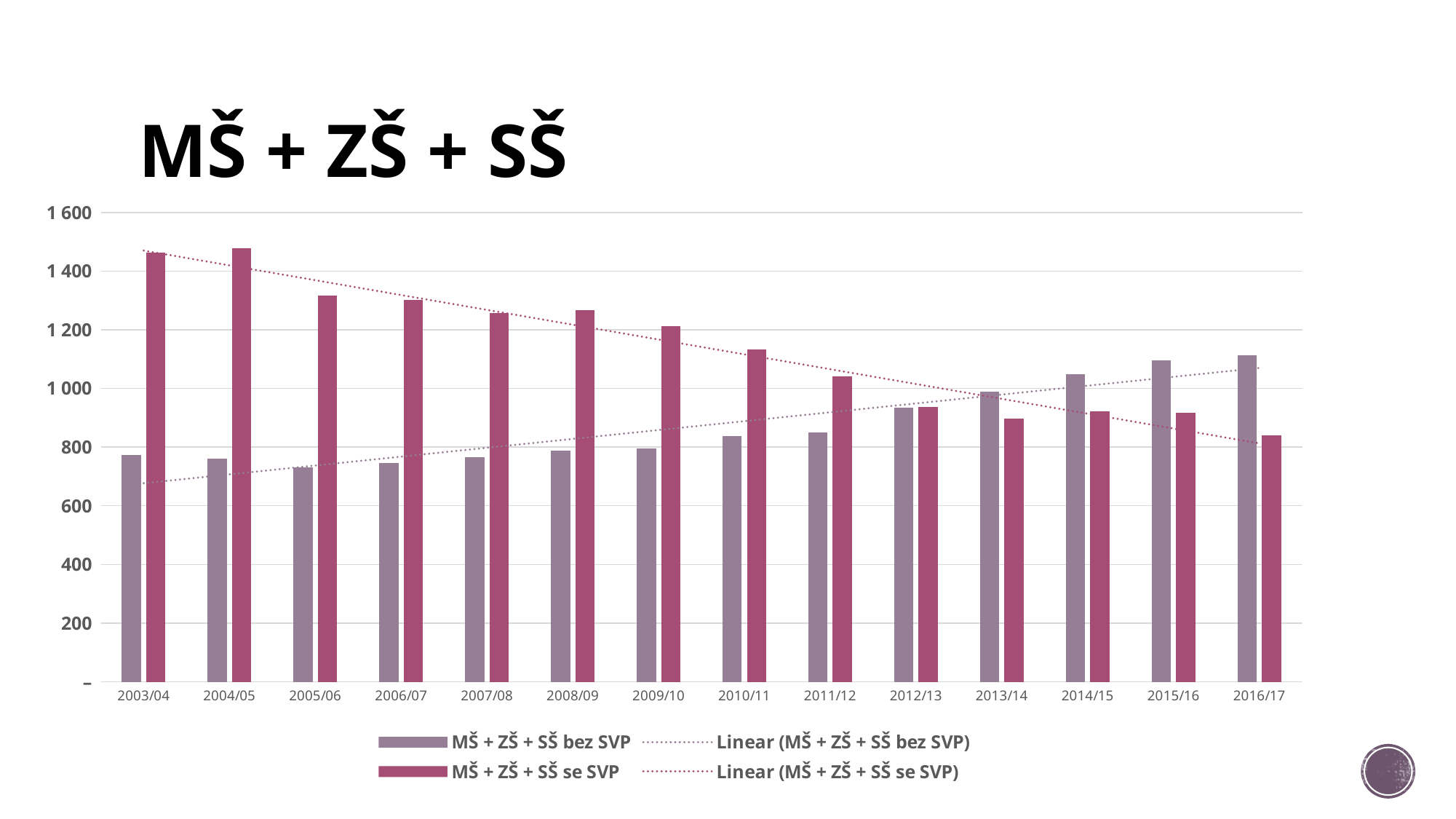
Which school year has the lowest value for 'MŠ + ZŠ + SŠ se SVP'? 2016/17 Do the values for 'MŠ + ZŠ + SŠ se SVP' generally rise or fall from 2003/04 to 2016/17? fall Is the value for 'MŠ + ZŠ + SŠ se SVP' in 2013/14 greater or less than 1 000? less How many school years are shown on the x axis? 14 What kind of chart is shown on the slide? bar chart Is the value for 'MŠ + ZŠ + SŠ bez SVP' in 2016/17 greater or less than 1 000? greater In 2003/04, which series has the larger value: 'MŠ + ZŠ + SŠ bez SVP' or 'MŠ + ZŠ + SŠ se SVP'? MŠ + ZŠ + SŠ se SVP What is the title of the chart? MŠ + ZŠ + SŠ Is the value for 'MŠ + ZŠ + SŠ se SVP' in 2003/04 greater or less than 1 400? greater In 2016/17, which series has the larger value: 'MŠ + ZŠ + SŠ bez SVP' or 'MŠ + ZŠ + SŠ se SVP'? MŠ + ZŠ + SŠ bez SVP How many entries does the legend list? 4